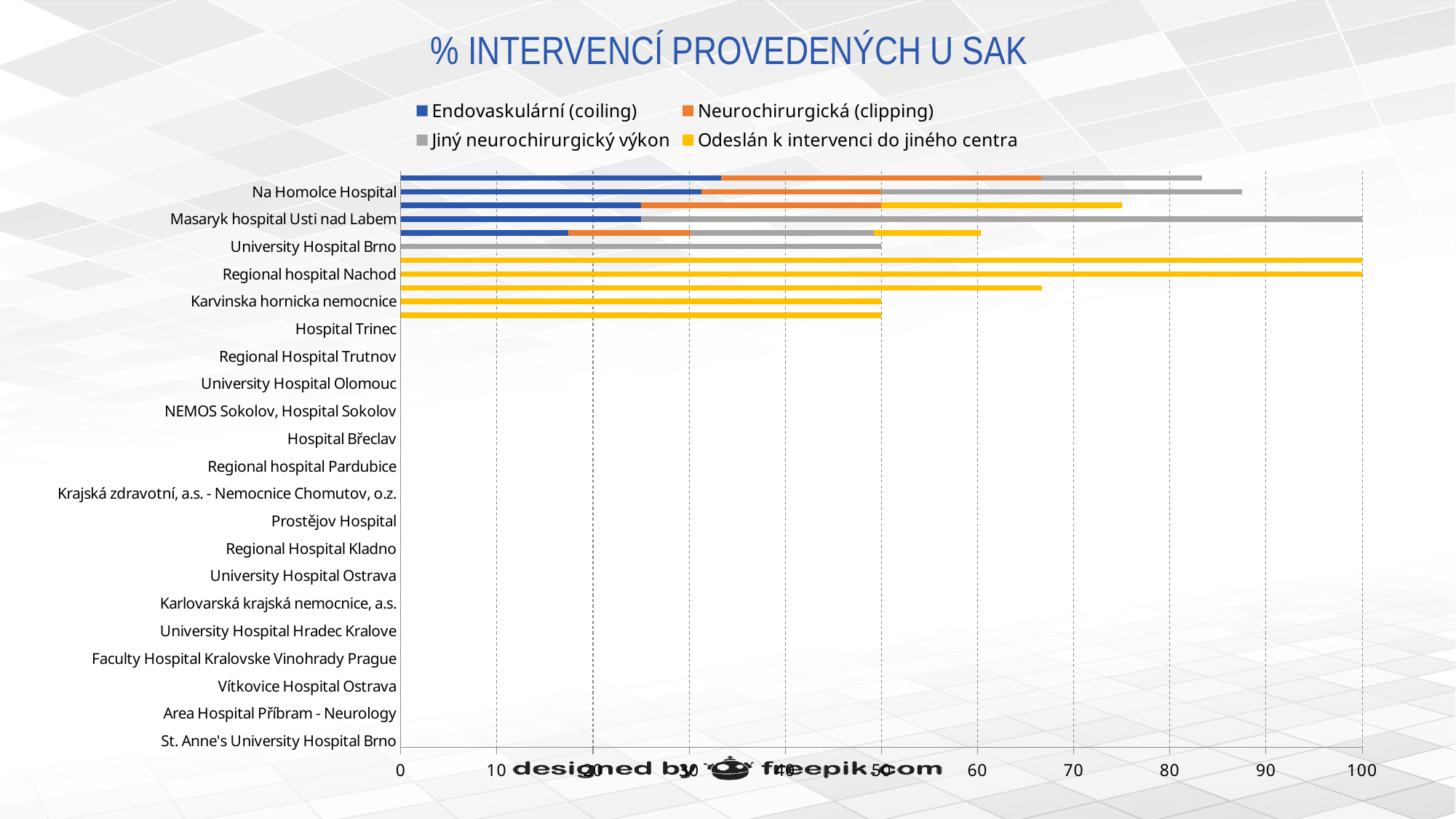
Is the Endovaskulární (coiling) value for Masaryk hospital Usti nad Labem greater or less than 30? less Which has the longer total bar, Regional hospital Nachod or Karvinska hornicka nemocnice? Regional hospital Nachod Is the value for Karvinska hornicka nemocnice greater or less than 60? less What kind of chart is shown on the slide? bar chart Is the value for University Hospital Brno greater or less than 60? less What is the title of the chart? % INTERVENCÍ PROVEDENÝCH U SAK How many series does the legend list? 4 Which legend entry is shown in orange? Neurochirurgická (clipping)